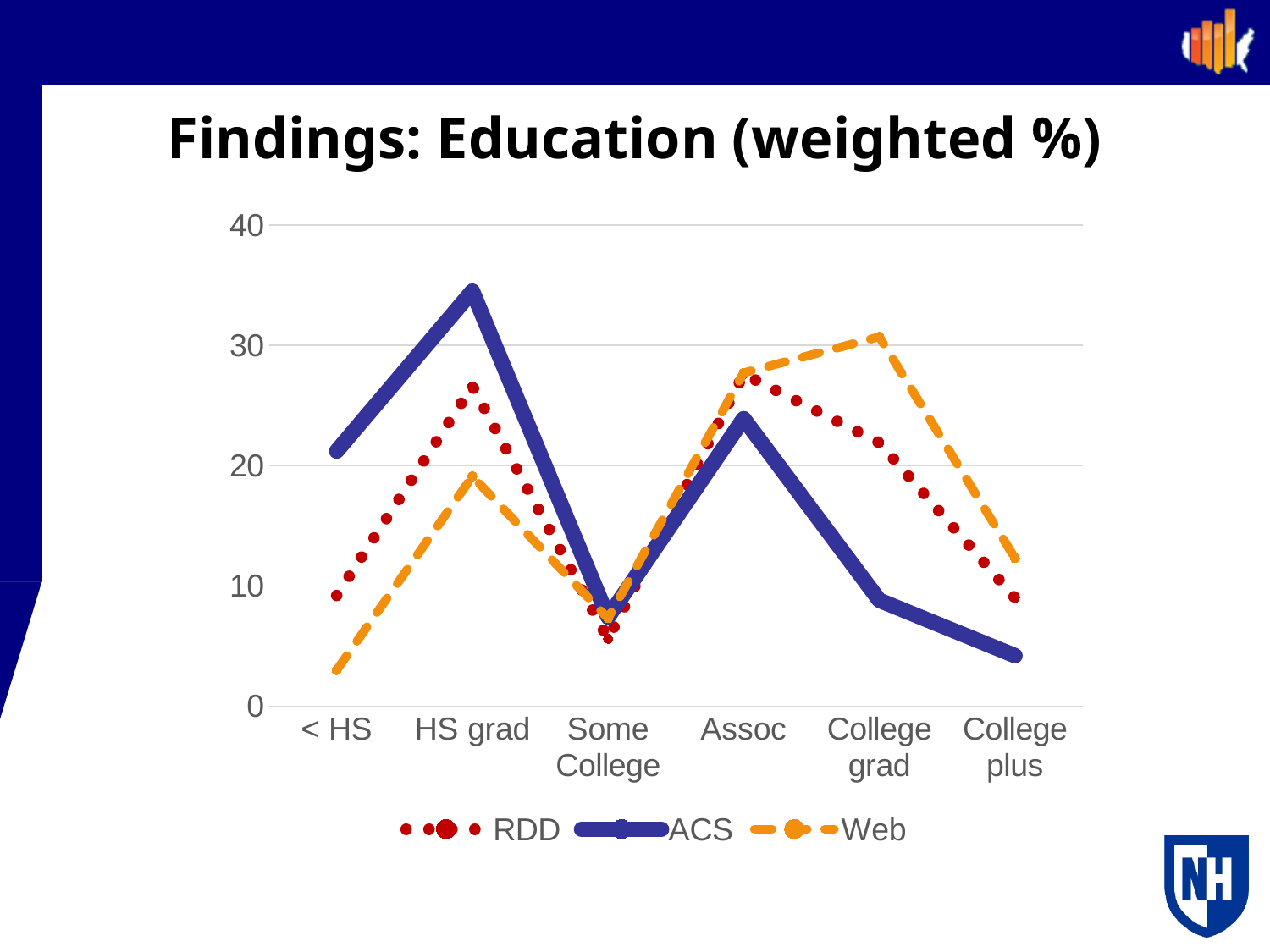
How many education categories are shown on the x axis? 6 Is the ACS value for College plus greater or less than 10? less Is the ACS value for HS grad greater or less than 30? greater How many series does the legend list? 3 Which series has the larger value for College grad, ACS or Web? Web Is the Web value for < HS greater or less than 10? less For which education category is the ACS series highest? HS grad Does the ACS series rise or fall from Assoc to College plus? fall For which education category is the Web series lowest? < HS What is the title of the chart? Findings: Education (weighted %) What kind of chart is shown on the slide? line chart